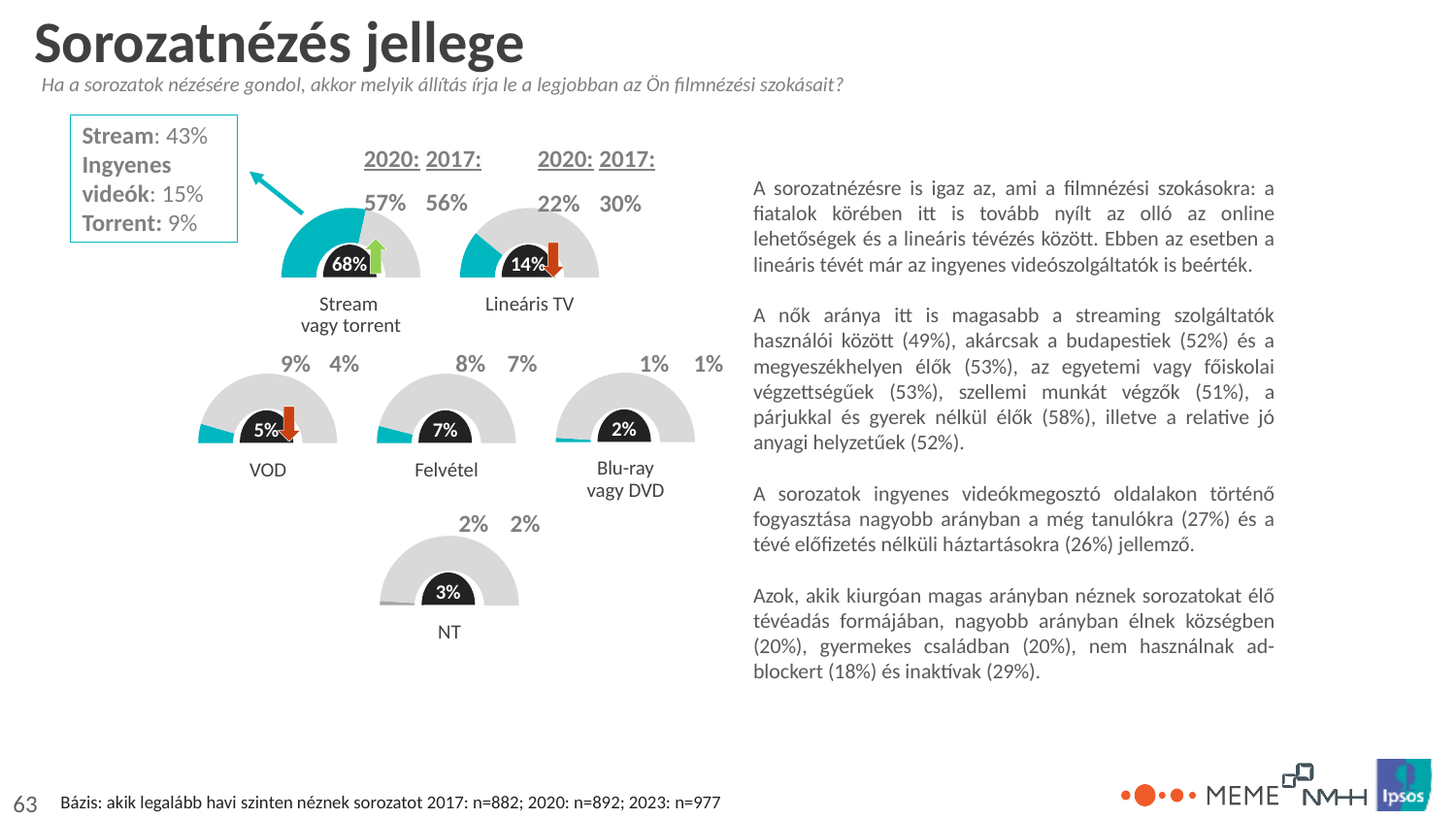
What is the current value shown in the gauge for 'Stream vagy torrent'? 68% What was the 2020 value for 'VOD'? 9% How many gauge charts are shown on the slide? 6 What is the difference between the 2017 and 2020 values for 'Lineáris TV'? 8 percentage points Which category has the lowest current value across the gauges? Blu-ray vagy DVD Which is larger: the current value for 'Felvétel' or the current value for 'VOD'? Felvétel What is the current value shown in the gauge for 'Lineáris TV'? 14% Which category has the highest current value across the gauges? Stream vagy torrent According to the callout box, what is the value for 'Torrent'? 9% What is the difference between the current value for 'Stream vagy torrent' and its 2020 value? 11 percentage points What kind of chart is used to display the values on the slide? Gauge (semi-circular doughnut) chart What was the 2017 value for 'Lineáris TV'? 30%